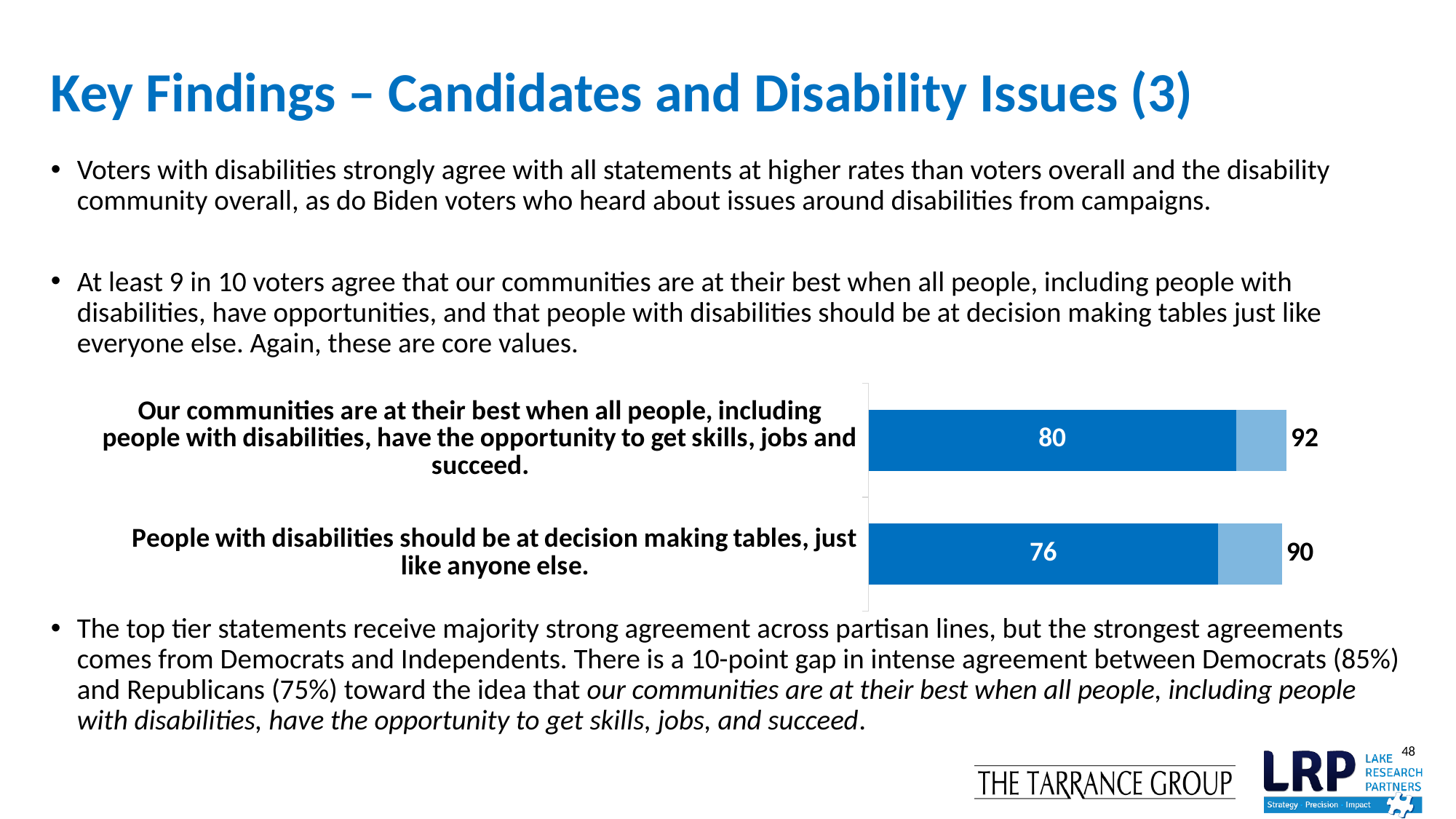
What value is printed inside the dark blue segment for the statement 'Our communities are at their best when all people, including people with disabilities, have the opportunity to get skills, jobs and succeed.'? 80 What value is printed at the end of the bar for 'Our communities are at their best when all people, including people with disabilities, have the opportunity to get skills, jobs and succeed.'? 92 Which statement has the lower value printed at the end of its bar? People with disabilities should be at decision making tables, just like anyone else. Is the dark blue value for 'People with disabilities should be at decision making tables, just like anyone else.' larger or smaller than the dark blue value for the 'Our communities are at their best...' statement? smaller What is the difference between the dark blue values of the two statements (80 and 76)? 4 How many colour segments make up each bar in the chart? 2 Which statement has the higher dark blue (strong agreement) value? Our communities are at their best when all people, including people with disabilities, have the opportunity to get skills, jobs and succeed. What is the difference between the end-of-bar values of the two statements (92 and 90)? 2 What value is printed inside the dark blue segment for the statement 'People with disabilities should be at decision making tables, just like anyone else.'? 76 What type of chart is shown on the slide? bar chart What value is printed at the end of the bar for 'People with disabilities should be at decision making tables, just like anyone else.'? 90 How many statements (categories) are plotted in the chart? 2